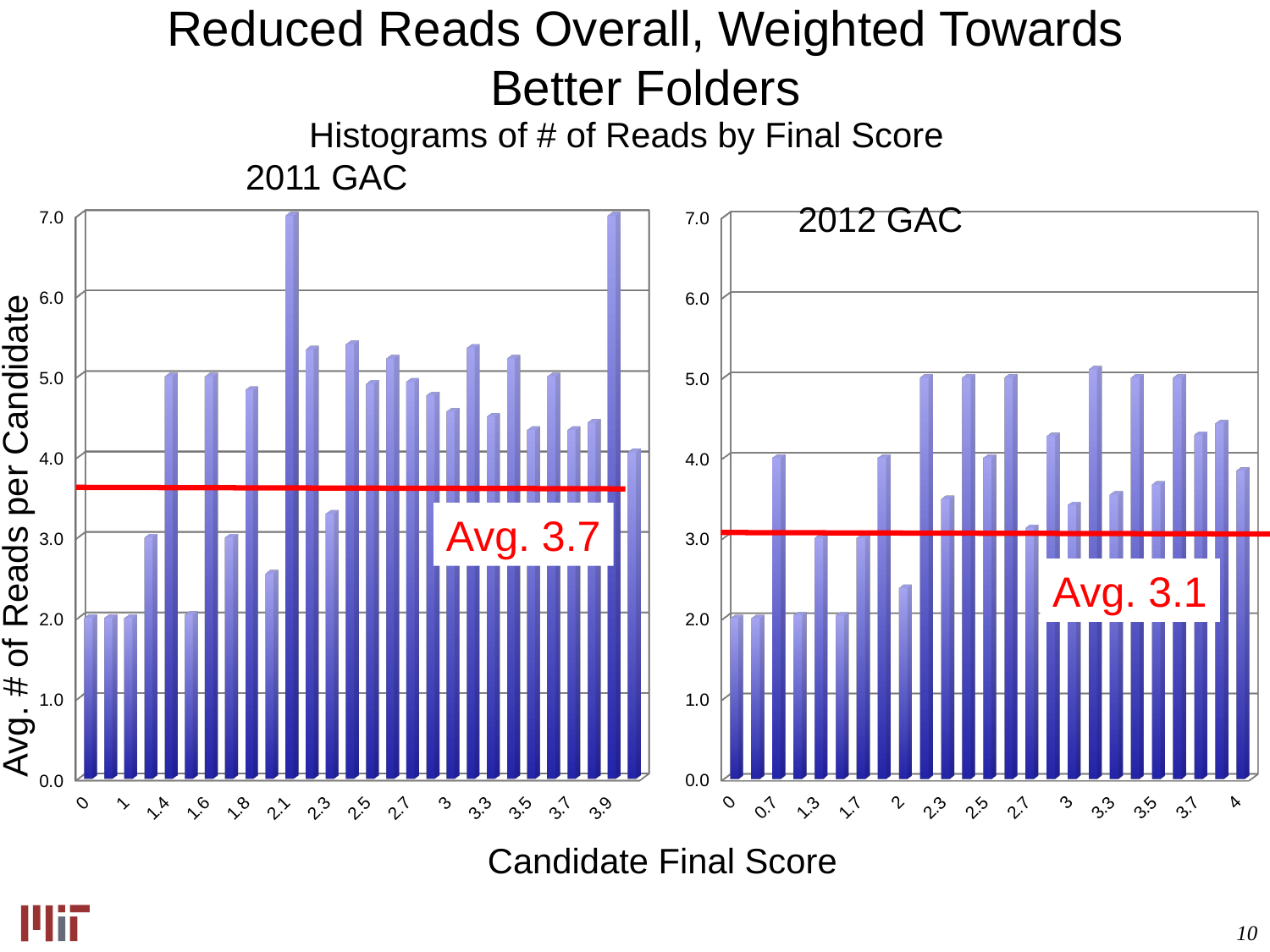
In the 2012 GAC chart, is the tallest bar greater or less than 6.0? less In the 2011 GAC chart, do the bar values generally rise or fall as the candidate final score increases? rise In the 2011 GAC chart, is the value for final score 0 greater or less than 3.0? less What kind of chart is the 2011 GAC chart? bar chart In the 2012 GAC chart, is the value for final score 4 greater or less than 3.0? greater What is the difference between the annotated averages of the 2011 GAC and 2012 GAC charts? 0.6 Which chart shows the higher annotated average number of reads, 2011 GAC or 2012 GAC? 2011 GAC In the 2011 GAC chart, what is the value reached by the tallest bars? 7.0 What average number of reads is annotated on the 2012 GAC chart? Avg. 3.1 What average number of reads is annotated on the 2011 GAC chart? Avg. 3.7 In the 2012 GAC chart, do the bar values generally rise or fall as the candidate final score increases? rise